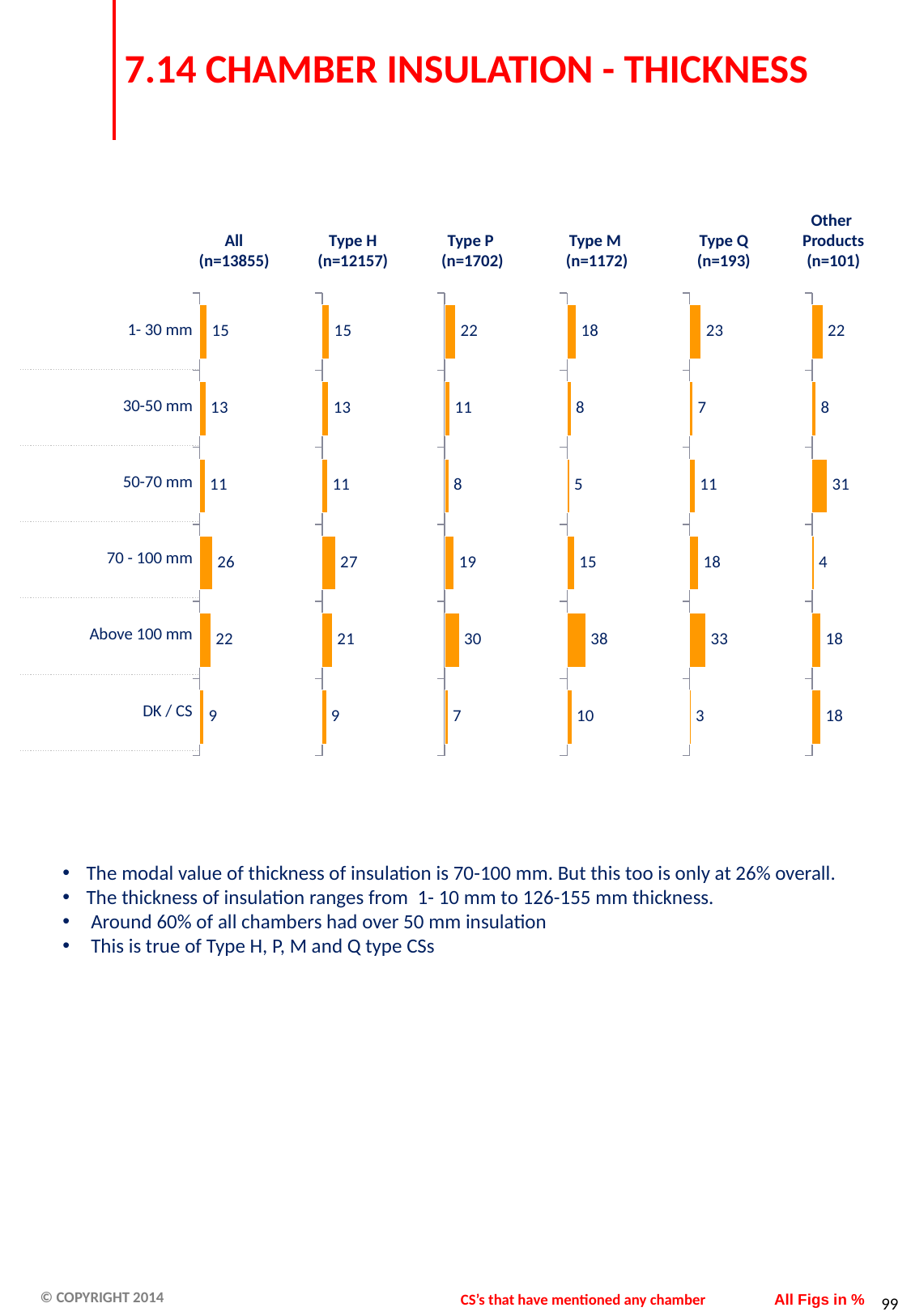
What kind of chart is used for the 'Type H (n=12157)' column? Bar chart In the 'Other Products (n=101)' chart, what is the value for 70 - 100 mm? 4 In the 'All (n=13855)' chart, what is the value for 70 - 100 mm? 26 In the 'Type M (n=1172)' chart, which is larger: the value for 1- 30 mm or the value for 70 - 100 mm? 1- 30 mm In the 'Type Q (n=193)' chart, which category has the highest value? Above 100 mm How many categories are shown in the 'All (n=13855)' chart? 6 How many separate bar charts are shown on the slide? 6 In the 'Type Q (n=193)' chart, what is the difference between the values for Above 100 mm and DK / CS? 30 In the 'Type M (n=1172)' chart, what is the value for Above 100 mm? 38 In the 'Type H (n=12157)' chart, what is the difference between the values for 70 - 100 mm and 30-50 mm? 14 In the 'Type P (n=1702)' chart, which category has the lowest value? DK / CS In the 'Other Products (n=101)' chart, what is the value for 50-70 mm? 31